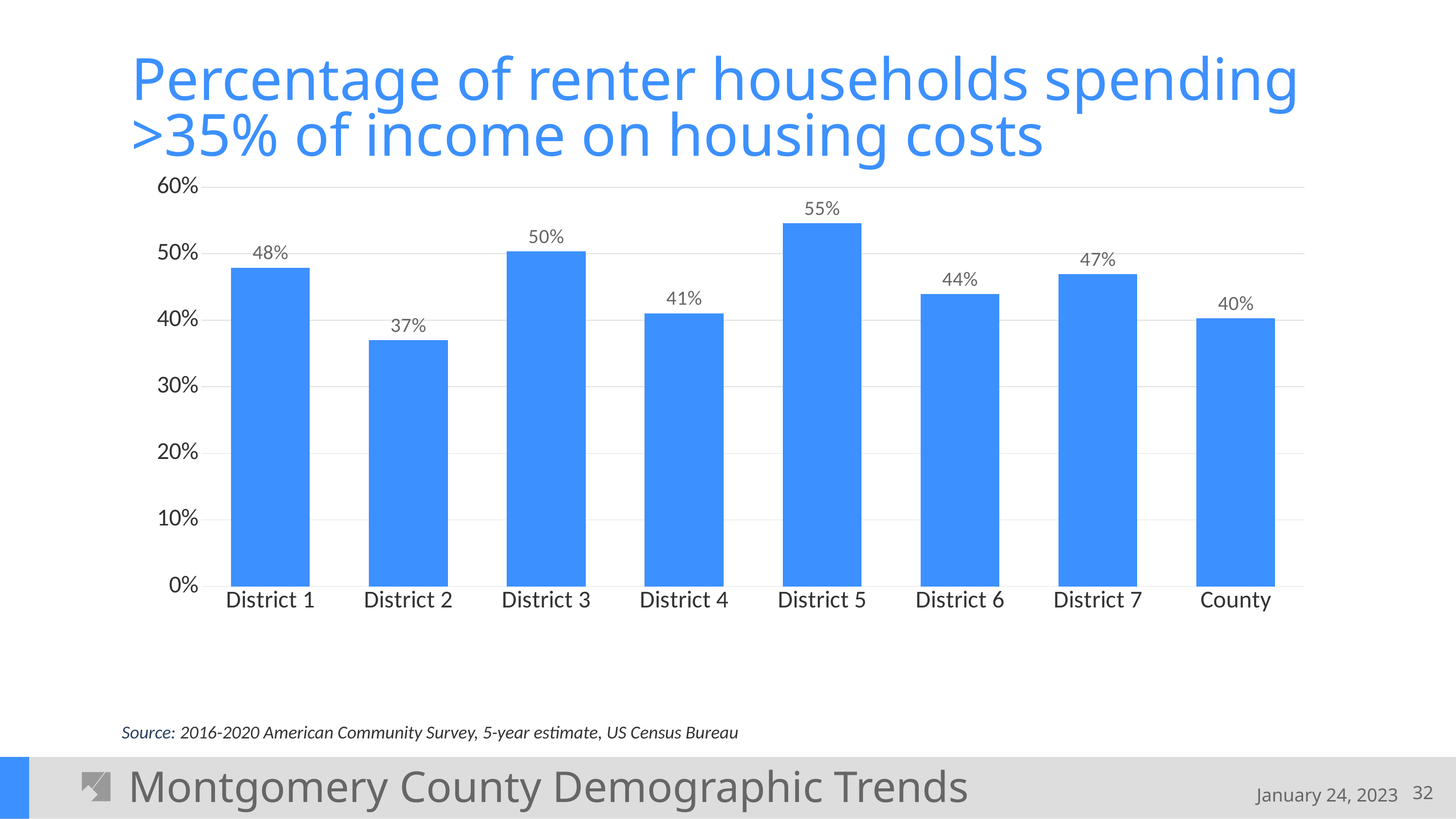
Which has a higher value, District 3 or District 6? District 3 Which category has the lowest value on the chart? District 2 How many categories are shown on the x axis of the chart? 8 Which category has the highest percentage of renter households spending more than 35% of income on housing costs? District 5 What percentage of renter households in District 5 spend more than 35% of income on housing costs? 55% What is the difference between the values for District 1 and the County? 8% What is the value shown for County? 40% What kind of chart is shown on the slide? Bar chart What is the difference between the values for District 5 and District 2? 18% Is the value for District 4 greater or less than 50%? less What is the source cited for the chart data? 2016-2020 American Community Survey, 5-year estimate, US Census Bureau What is the value shown for District 2? 37%